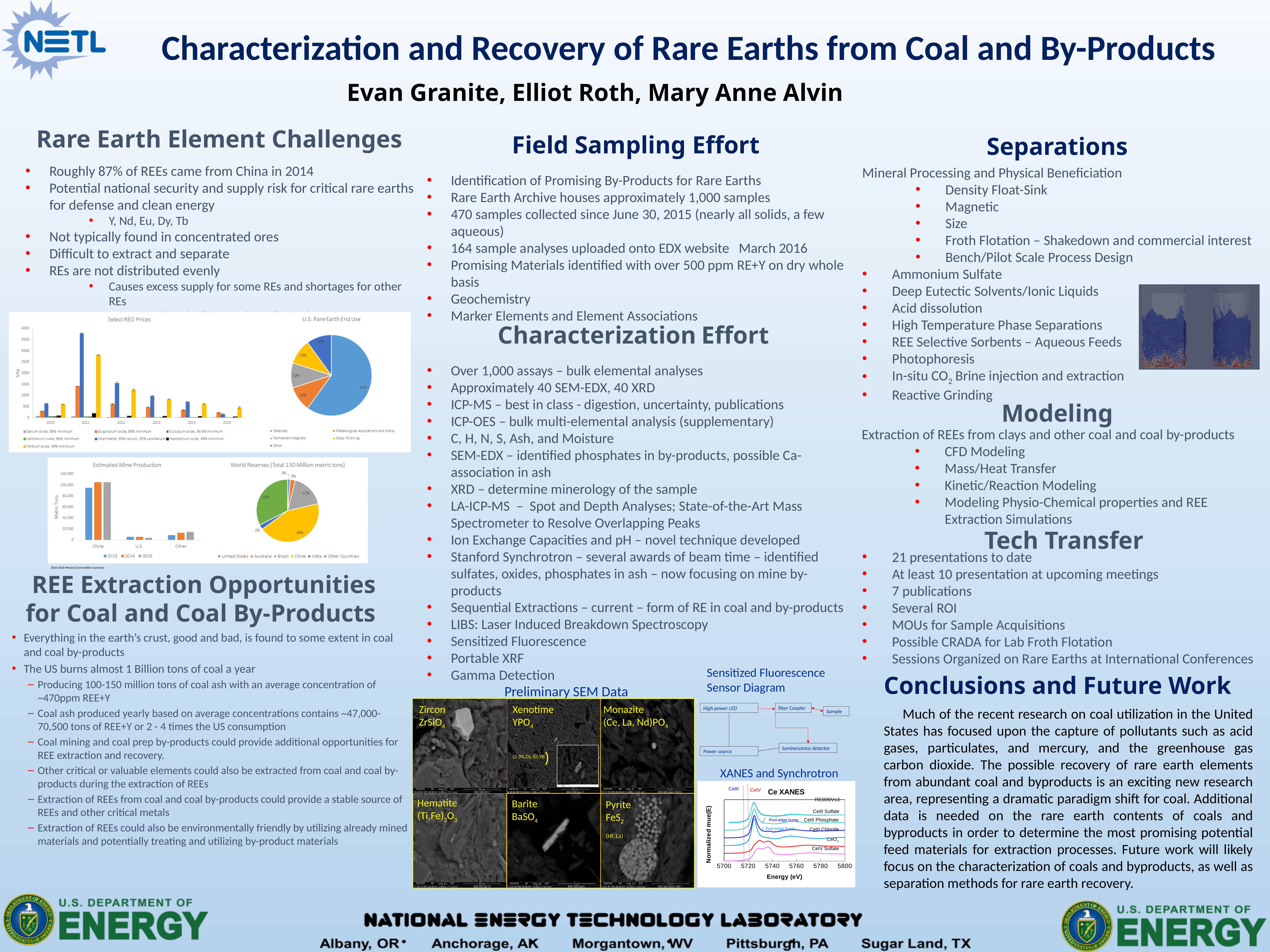
In the U.S. Rare Earth End Use pie chart, what share of end use is Catalysts? 60% In the World Reserves pie chart, which country has the largest share of reserves? China In the World Reserves pie chart, what is the difference in percentage points between China's share and Other Countries' share? 11 In the Estimated Mine Production chart, is the value for China in 2013 greater or less than 80,000? greater In the Estimated Mine Production chart, which country has the highest mine production? China In the World Reserves pie chart, what share of reserves does China hold? 44% In the World Reserves pie chart, which has the larger share, Brazil or Australia? Brazil How many series does the legend of the Estimated Mine Production chart list? 3 In the U.S. Rare Earth End Use pie chart, which end use has the largest share? Catalysts What is the x-axis label of the Ce XANES chart? Energy (eV) How many slices does the U.S. Rare Earth End Use pie chart have? 5 What kind of chart is the Select REO Prices chart? bar chart